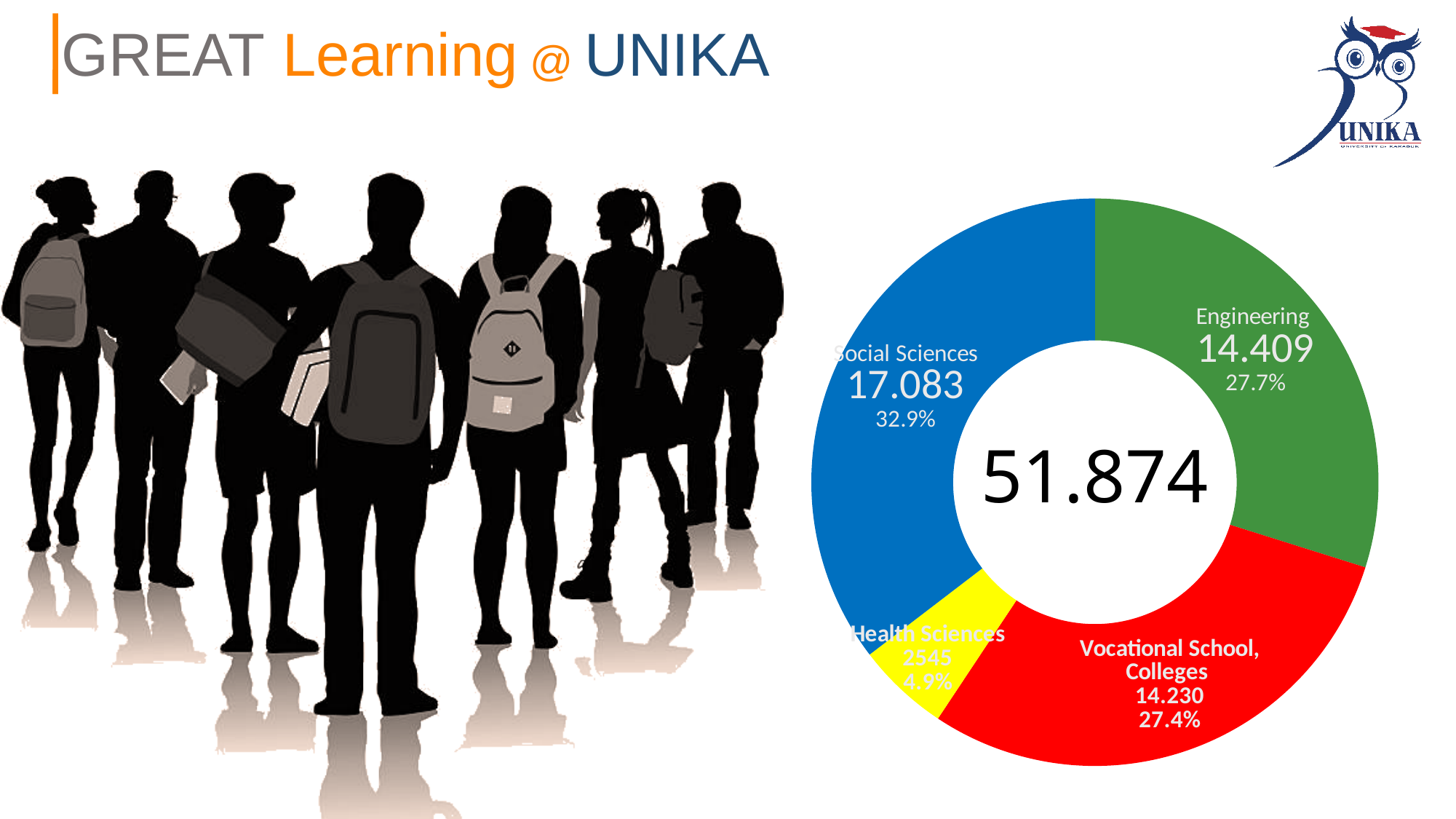
Which category has the smallest share of the doughnut chart? Health Sciences What is the value for Vocational School, Colleges in the doughnut chart? 14.230 Which category has the largest share of the doughnut chart? Social Sciences What is the total shown in the centre of the doughnut chart? 51.874 What percentage share does Health Sciences have in the doughnut chart? 4.9% What is the value for Engineering in the doughnut chart? 14.409 What is the value for Health Sciences in the doughnut chart? 2545 What percentage share does Engineering have in the doughnut chart? 27.7% Which colour represents Vocational School, Colleges in the doughnut chart? red How many categories does the doughnut chart show? 4 What kind of chart is shown on the slide? doughnut chart What is the value for Social Sciences in the doughnut chart? 17.083